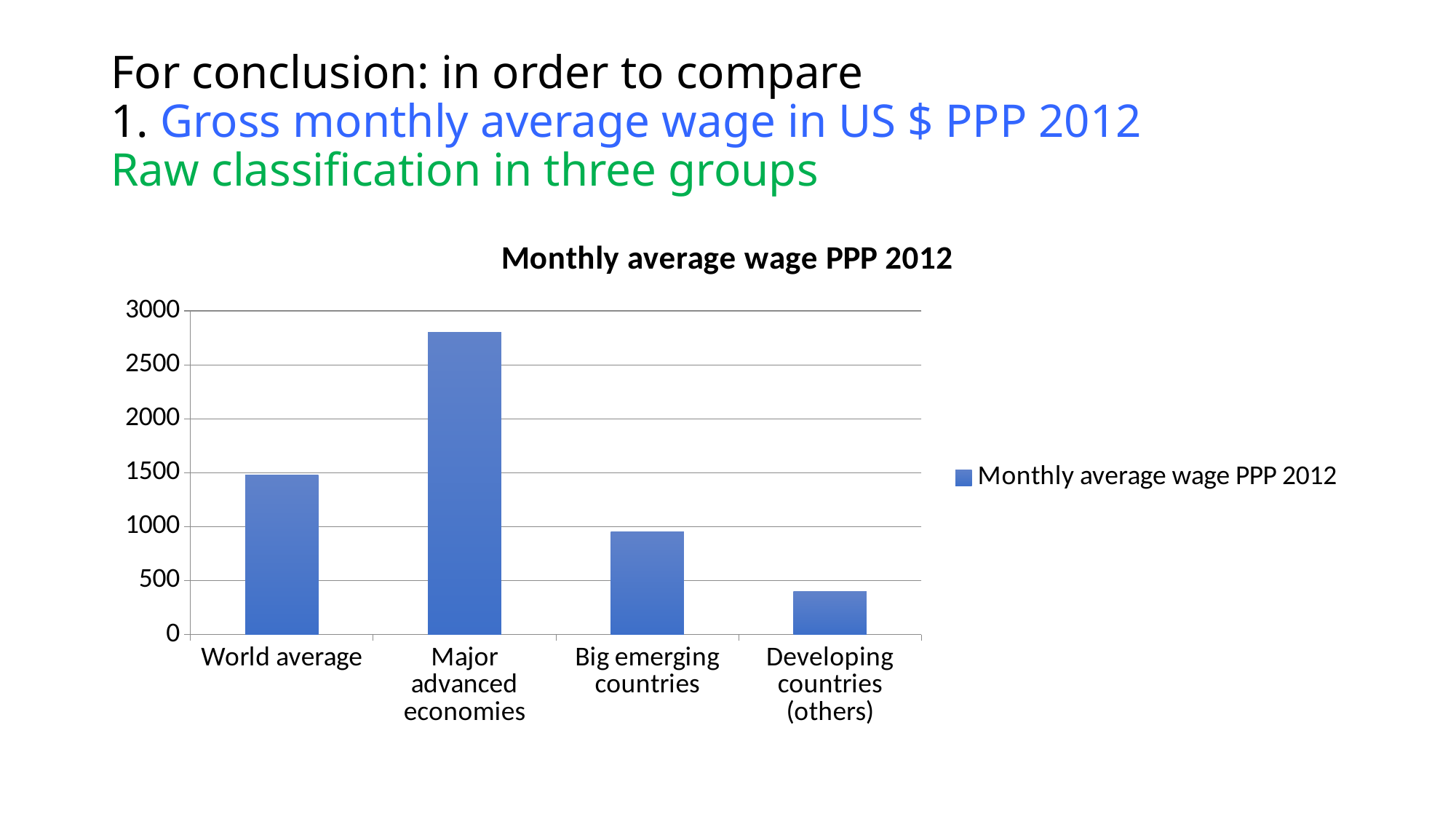
Is the value for Developing countries (others) greater or less than 500? less Is the value for Big emerging countries greater or less than 1000? less Which category has the lowest monthly average wage in the chart? Developing countries (others) Is the value for Major advanced economies greater or less than 2500? greater What is the name of the series listed in the chart legend? Monthly average wage PPP 2012 Which is larger, the value for World average or the value for Big emerging countries? World average How many series does the chart legend list? 1 What is the title of the chart? Monthly average wage PPP 2012 How many categories are shown on the x axis of the chart? 4 What kind of chart is shown on the slide? bar chart Which category has the highest monthly average wage in the chart? Major advanced economies